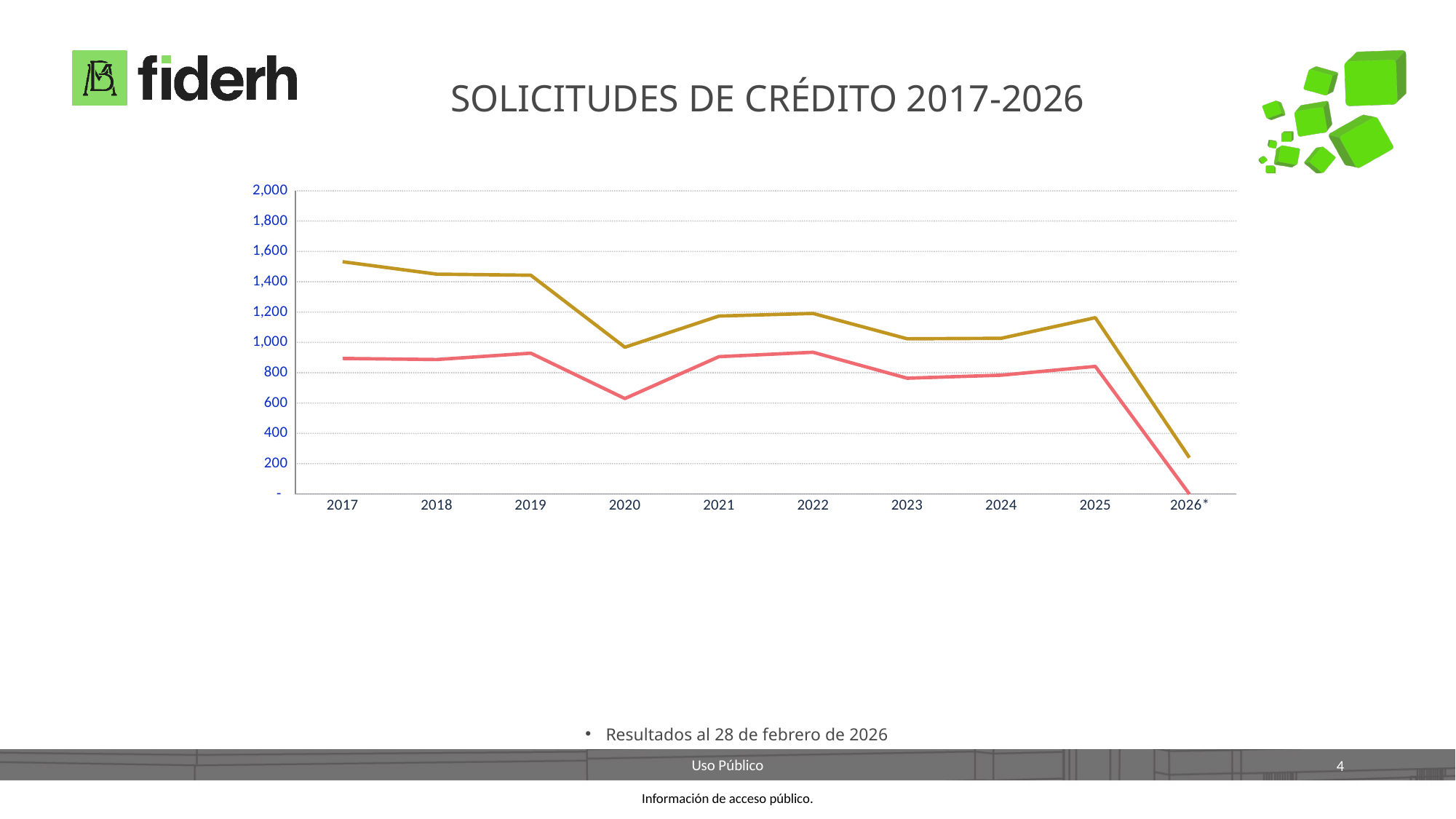
In 2019, which line has the higher value, the gold line or the pink line? the gold line In which year does the gold line reach its lowest value? 2026* Is the value of the gold line for 2017 greater or less than 1,400? greater How many years are shown along the x axis of the chart? 10 What is the title of the chart? SOLICITUDES DE CRÉDITO 2017-2026 Is the value of the gold line for 2022 greater or less than 1,000? greater What kind of chart is shown on the slide? line chart Does the pink line rise or fall between 2025 and 2026*? fall Is the value of the pink line for 2022 greater or less than 800? greater In which year does the gold line reach its highest value? 2017 How many lines are plotted on the chart? 2